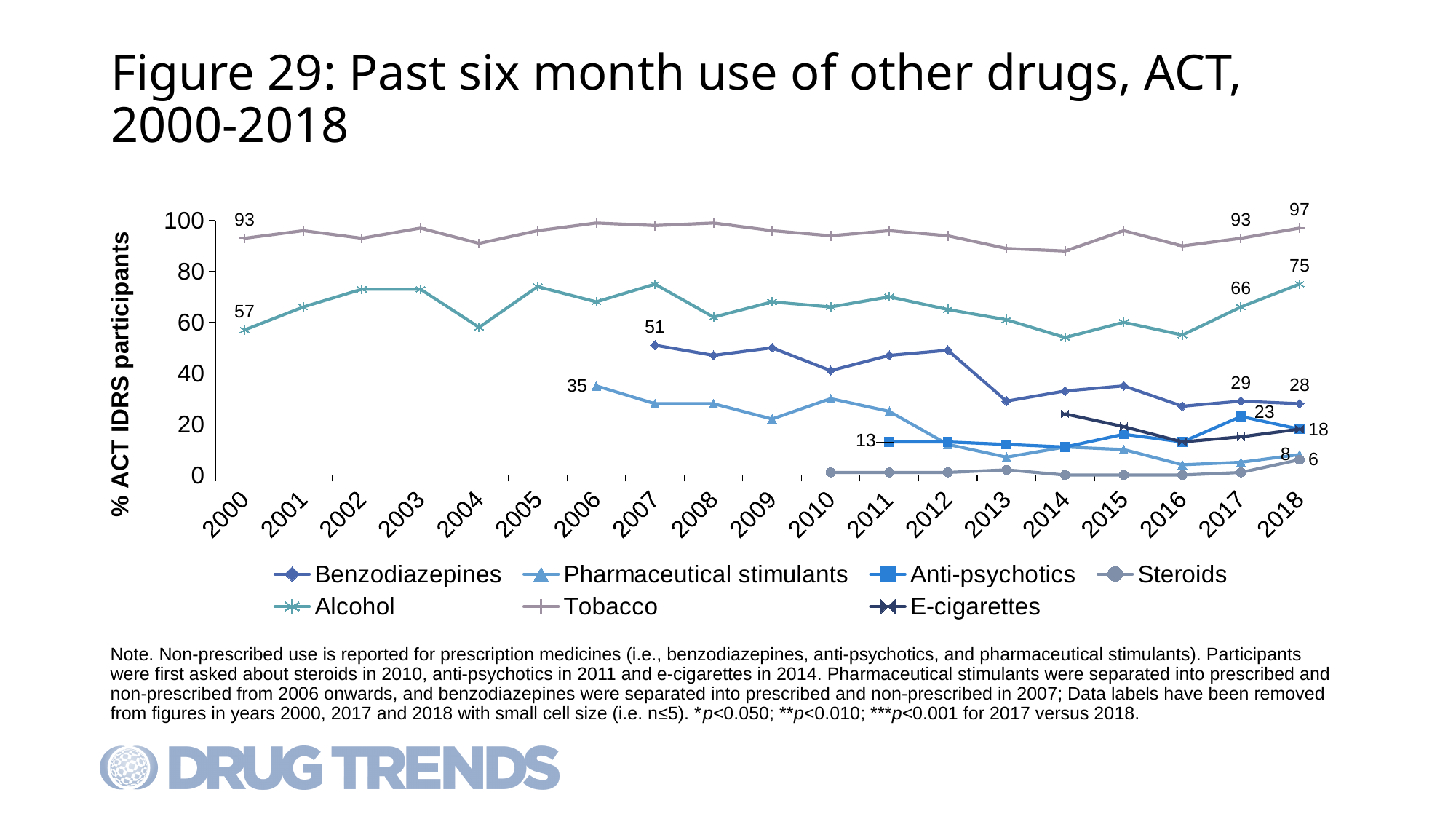
What is the value for Tobacco in 2018? 97 Is the value for Benzodiazepines in 2013 greater or less than 40? less Which series has the highest value in 2018? Tobacco What is the value for Steroids in 2018? 6 What is the value for Pharmaceutical stimulants in 2006? 35 By how much did the Tobacco value increase from 2017 to 2018? 4 How many series does the legend list? 7 What is the value for Benzodiazepines in 2007? 51 What is the value for Alcohol in 2000? 57 What is the value for Anti-psychotics in 2017? 23 What kind of chart is shown on the slide? line chart How many years are shown on the x axis? 19